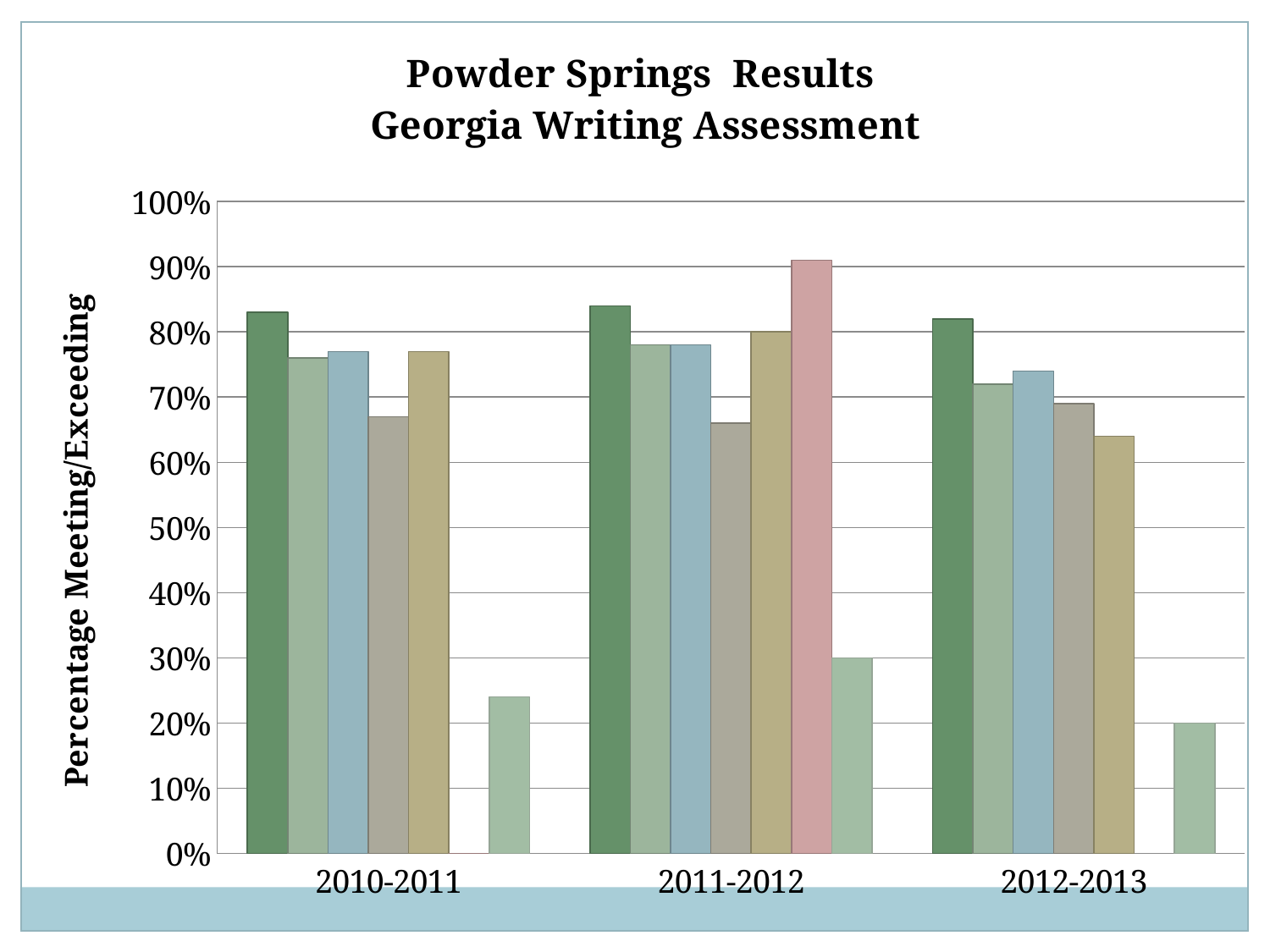
In the 2011-2012 group, which is larger: the pink bar or the dark green bar? the pink bar Which school-year group contains the tallest bar on the chart? 2011-2012 What is the label on the vertical axis? Percentage Meeting/Exceeding How many school-year categories are shown on the x axis? 3 What is the title of the chart? Powder Springs Results Georgia Writing Assessment Is the value of the dark green (first) bar in the 2010-2011 group greater or less than 80%? greater Is the value of the lightest green (last) bar in the 2012-2013 group greater or less than 30%? less What kind of chart is shown on the slide? bar chart How many bars are in the 2011-2012 group? 7 Is the lightest green (last) bar larger in 2010-2011 or in 2011-2012? 2011-2012 Is the value of the tan bar in the 2012-2013 group greater or less than 70%? less